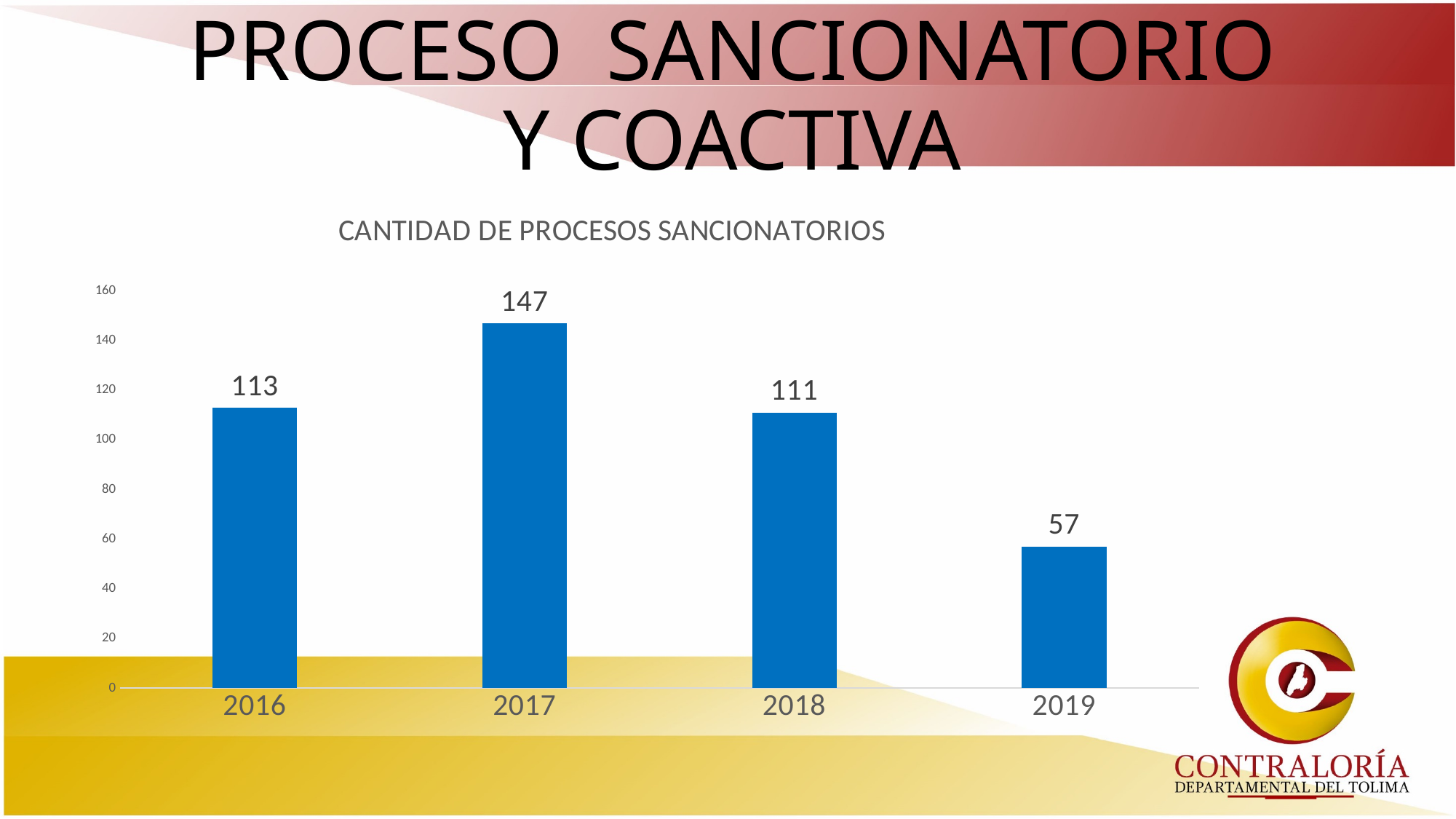
What is the title of the chart? CANTIDAD DE PROCESOS SANCIONATORIOS What is the difference between the values for 2017 and 2019? 90 Which year has the highest number of processes? 2017 Which is larger, the value for 2016 or the value for 2019? 2016 What is the value for 2017? 147 How many years are shown on the x axis? 4 What is the difference between the values for 2016 and 2018? 2 What kind of chart is shown? bar chart Which year has the lowest number of processes? 2019 What is the value for 2016? 113 What is the value for 2019? 57 What is the value for 2018? 111